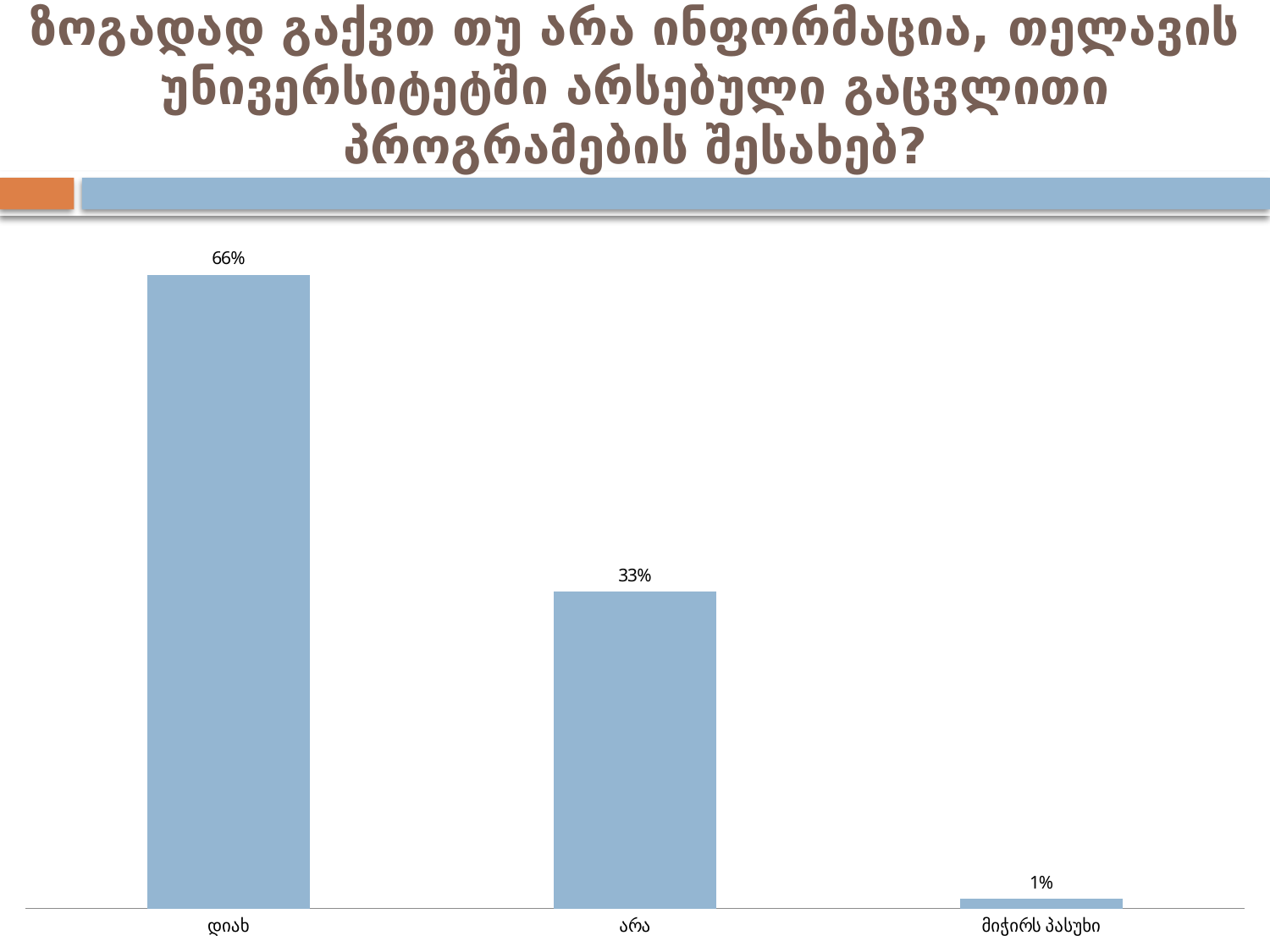
How many categories are shown on the x axis? 3 What is the value for მიჭირს პასუხი? 1% What kind of chart is shown on the slide? bar chart What colour are the bars in the chart? light blue What is the value for არა? 33% Which is larger, the value for დიახ or the value for არა? დიახ Which category has the lowest value? მიჭირს პასუხი Which category has the highest value? დიახ What is the value for დიახ? 66% Do the values rise or fall from left to right along the x axis? fall What is the difference between the values for არა and მიჭირს პასუხი? 32% What is the difference between the values for დიახ and არა? 33%